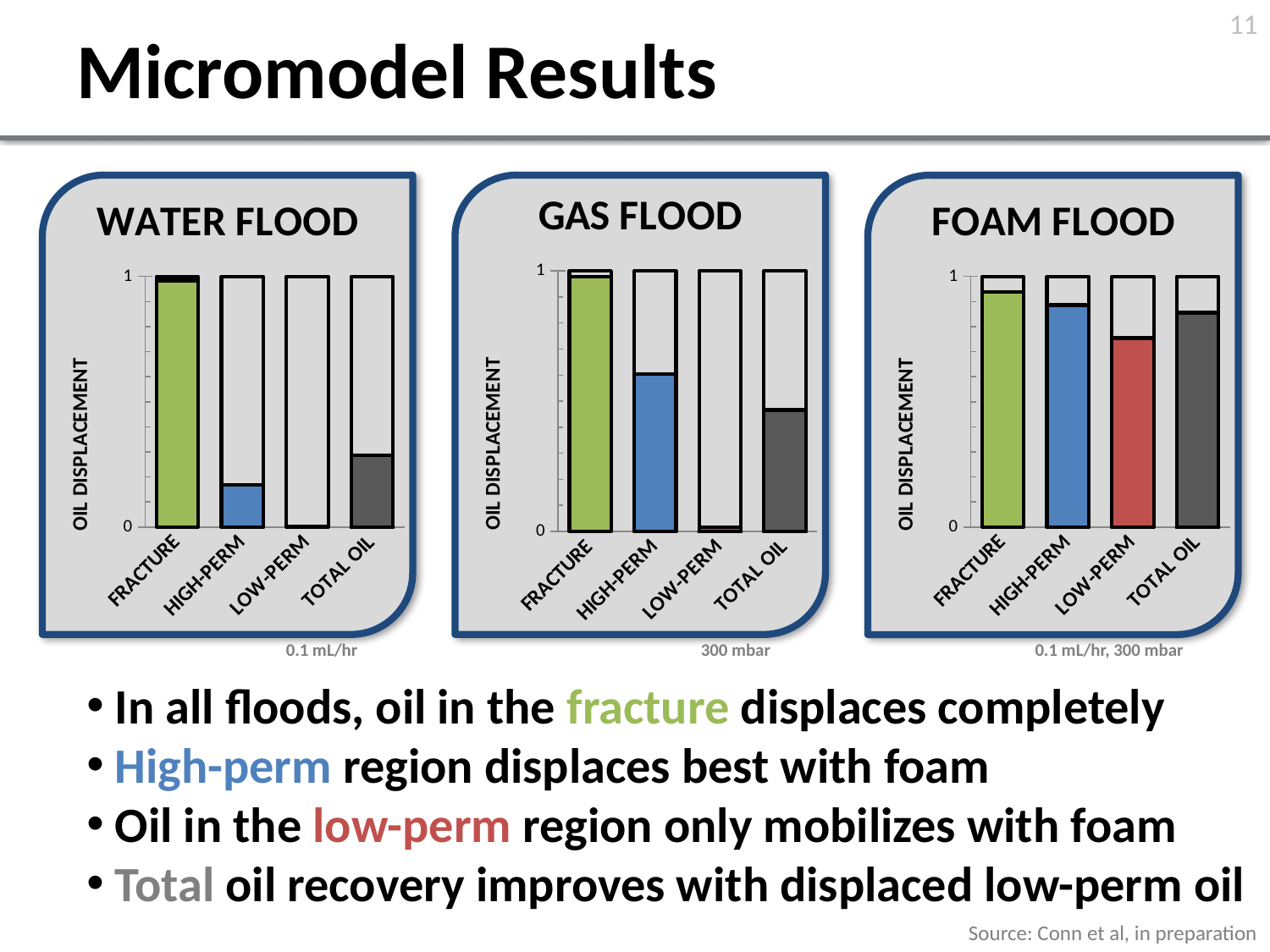
What is the y-axis label on the Foam Flood chart? Oil Displacement What condition is noted below the Gas Flood chart? 300 mbar In the Foam Flood chart, which category has the lowest oil displacement? Low-Perm In the Water Flood chart, which category has the lowest oil displacement? Low-Perm Is the Low-Perm value larger in the Foam Flood chart or in the Gas Flood chart? Foam Flood How many categories are plotted on the x axis of the Gas Flood chart? 4 In the Gas Flood chart, which is larger, the value for High-Perm or the value for Total Oil? High-Perm In the Gas Flood chart, which category has the lowest oil displacement? Low-Perm How many charts are shown on the slide? 3 What kind of chart is the Water Flood chart? Bar chart In the Water Flood chart, which is larger, the value for High-Perm or the value for Total Oil? Total Oil In the Water Flood chart, which category has the highest oil displacement? Fracture